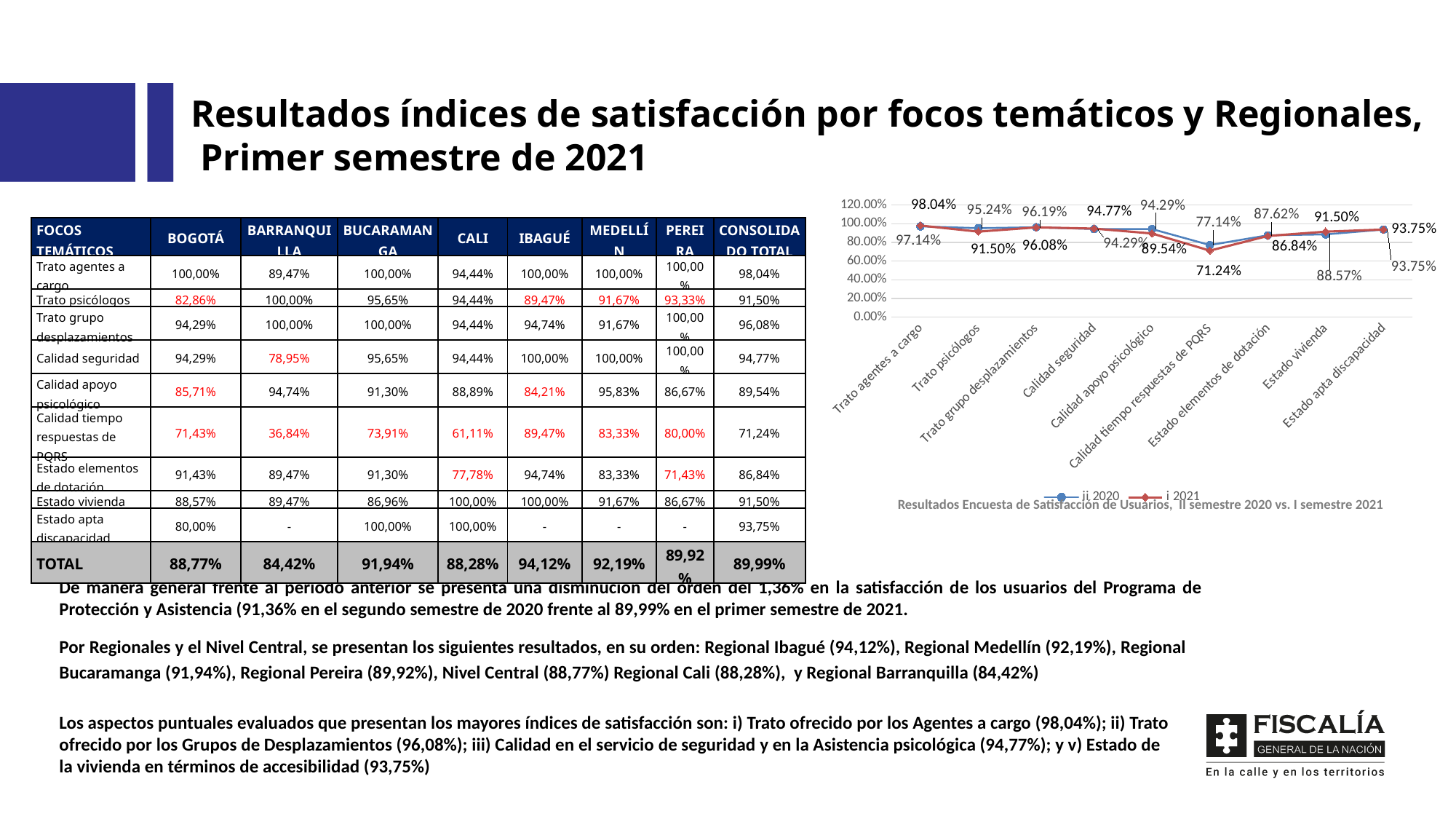
What are the two legend entries of the line chart? ii 2020 and i 2021 What is the difference between the two values labelled at Calidad tiempo respuestas de PQRS on the line chart? 5.90% What kind of chart is shown on the right of the slide? line chart Which category has the highest values on the line chart? Trato agentes a cargo How many categories are plotted along the x axis of the line chart? 9 On the line chart, are the values for Calidad tiempo respuestas de PQRS greater or less than 80.00%? less On the line chart, do the values rise or fall from Calidad apoyo psicológico to Calidad tiempo respuestas de PQRS? fall How many series does the legend of the line chart list? 2 Which category has the lowest values on the line chart? Calidad tiempo respuestas de PQRS What value is labelled for Estado apta discapacidad on the line chart? 93.75% What is the lower of the two values labelled at Calidad tiempo respuestas de PQRS on the line chart? 71.24% On the line chart, which category has higher values: Trato agentes a cargo or Estado vivienda? Trato agentes a cargo